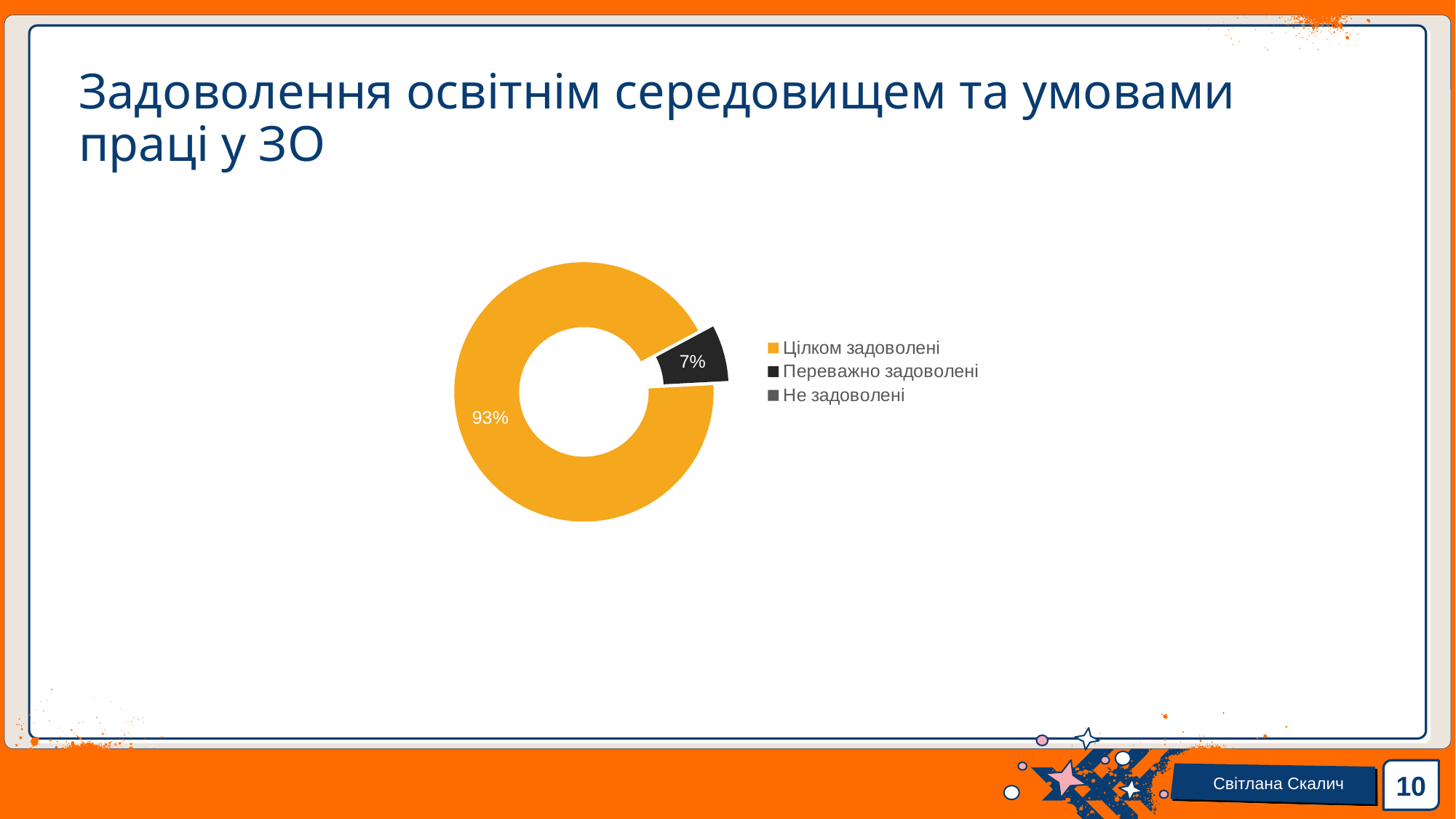
What is the difference in percentage points between "Цілком задоволені" and "Переважно задоволені"? 86 percentage points What share of respondents are "Переважно задоволені"? 7% What colour represents "Цілком задоволені" in the chart? Orange What kind of chart is shown on the slide? Doughnut (pie) chart Which category has the largest share of the chart? Цілком задоволені What colour represents "Переважно задоволені" in the chart? Black Which of the two labelled slices is smaller, "Цілком задоволені" or "Переважно задоволені"? Переважно задоволені How many entries does the legend list? 3 What is the combined share of the two labelled slices, "Цілком задоволені" and "Переважно задоволені"? 100% What share of respondents are "Цілком задоволені"? 93% Which is larger: the share for "Цілком задоволені" or for "Переважно задоволені"? Цілком задоволені